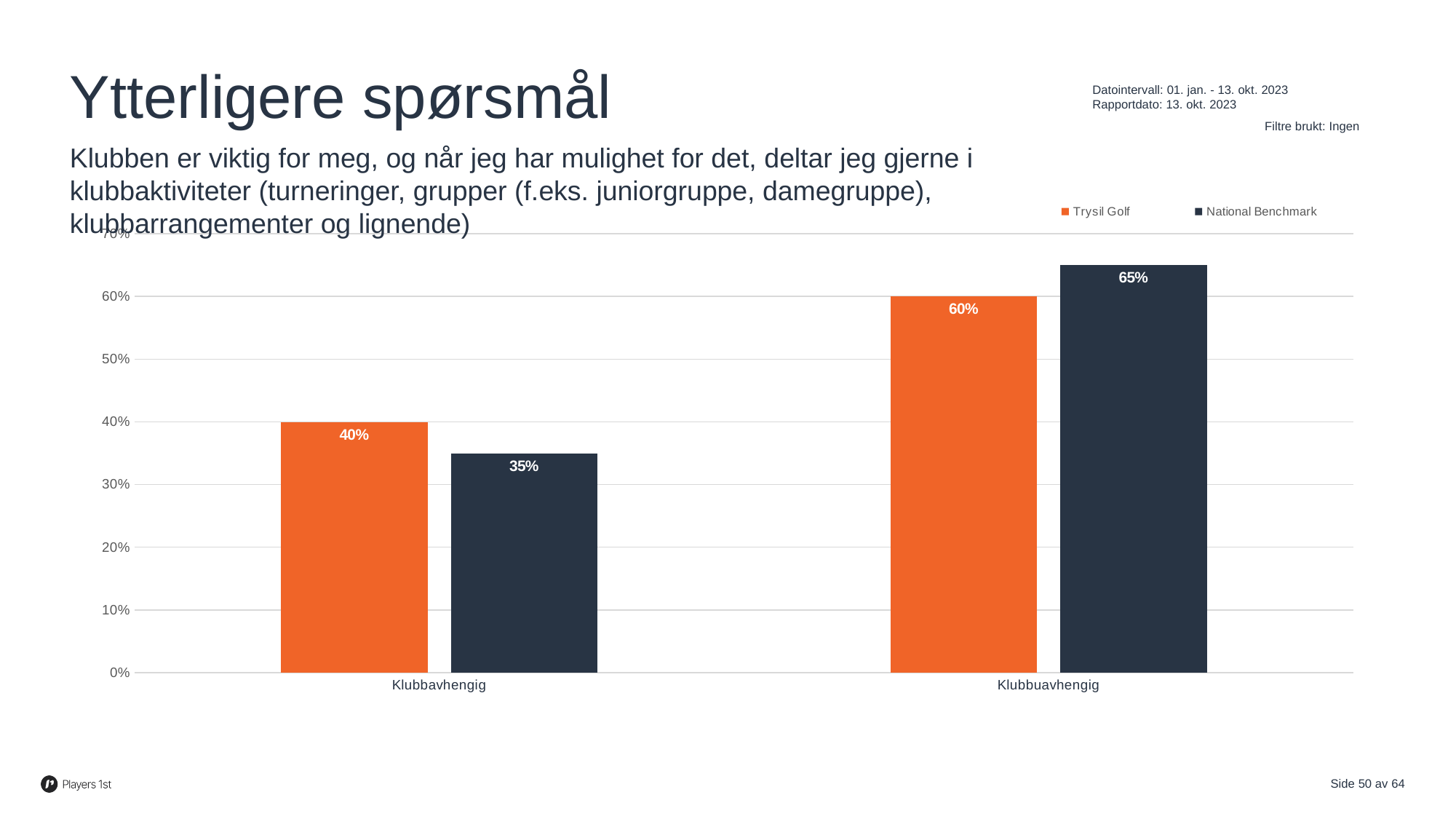
What kind of chart is shown on the slide? Bar chart How many series does the legend list? 2 How many categories are shown on the x axis? 2 In the Klubbavhengig category, which is larger: Trysil Golf or National Benchmark? Trysil Golf Which category has the lowest value for National Benchmark? Klubbavhengig What is the value for National Benchmark in the Klubbuavhengig category? 65% What is the value for Trysil Golf in the Klubbavhengig category? 40% What is the difference between the National Benchmark and Trysil Golf values in the Klubbuavhengig category? 5% Is the value for National Benchmark in the Klubbuavhengig category greater or less than 60%? greater What is the value for National Benchmark in the Klubbavhengig category? 35% Which category has the highest value for Trysil Golf? Klubbuavhengig What is the value for Trysil Golf in the Klubbuavhengig category? 60%